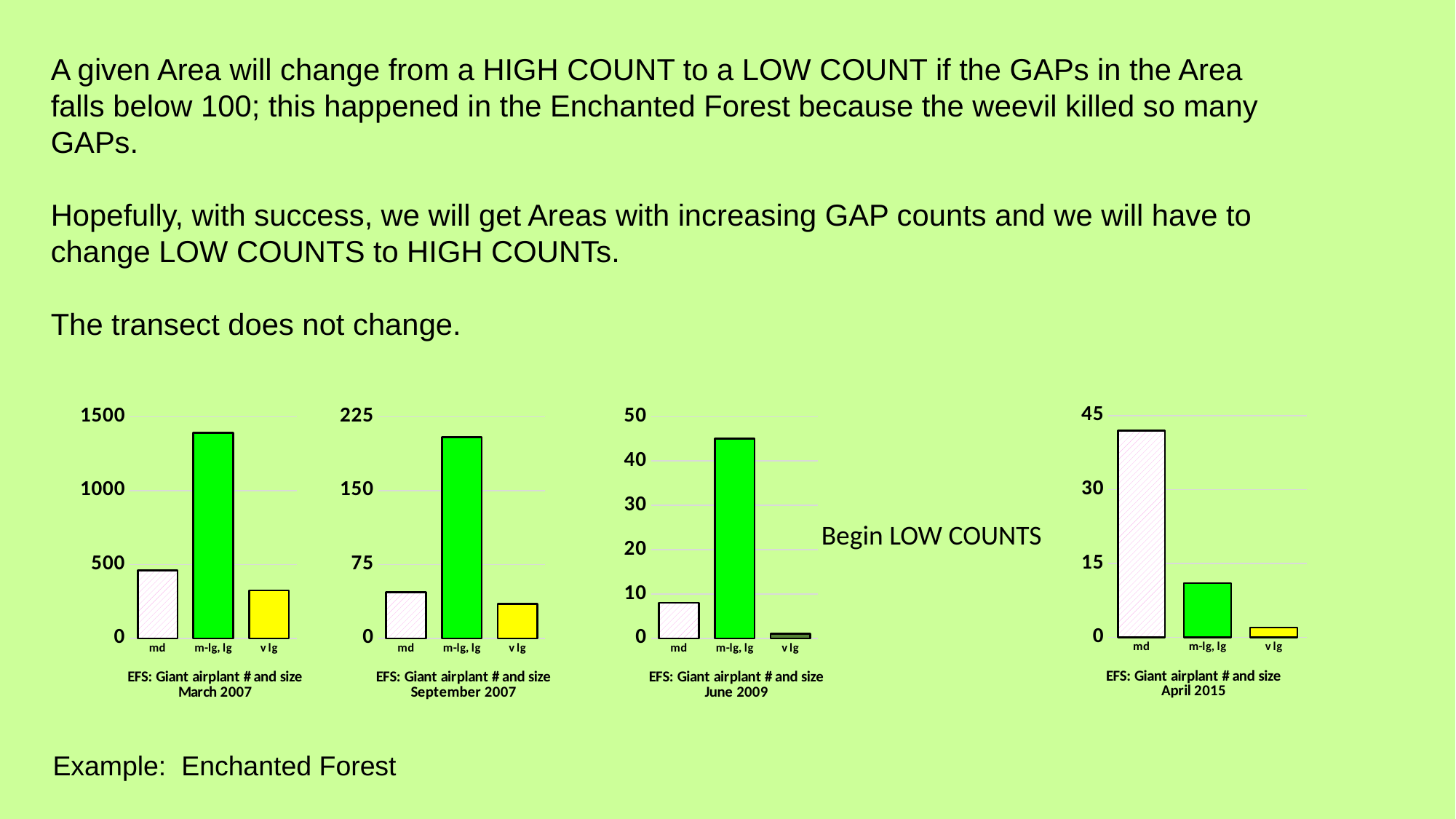
What kind of chart is the 'EFS: Giant airplant # and size March 2007' chart? bar chart In the 'EFS: Giant airplant # and size March 2007' chart, which category has the highest value? m-lg, lg In the 'EFS: Giant airplant # and size March 2007' chart, is the value for m-lg, lg greater or less than 1000? greater How many categories are shown on the x axis of the 'EFS: Giant airplant # and size June 2009' chart? 3 What text label is placed next to the 'EFS: Giant airplant # and size June 2009' chart? Begin LOW COUNTS In the 'EFS: Giant airplant # and size June 2009' chart, is the value for md greater or less than 10? less In the 'EFS: Giant airplant # and size April 2015' chart, is the value for m-lg, lg greater or less than 15? less In the 'EFS: Giant airplant # and size April 2015' chart, which category has the highest value? md In the 'EFS: Giant airplant # and size June 2009' chart, which category has the lowest value? v lg In the 'EFS: Giant airplant # and size September 2007' chart, which is larger, the value for md or the value for m-lg, lg? m-lg, lg